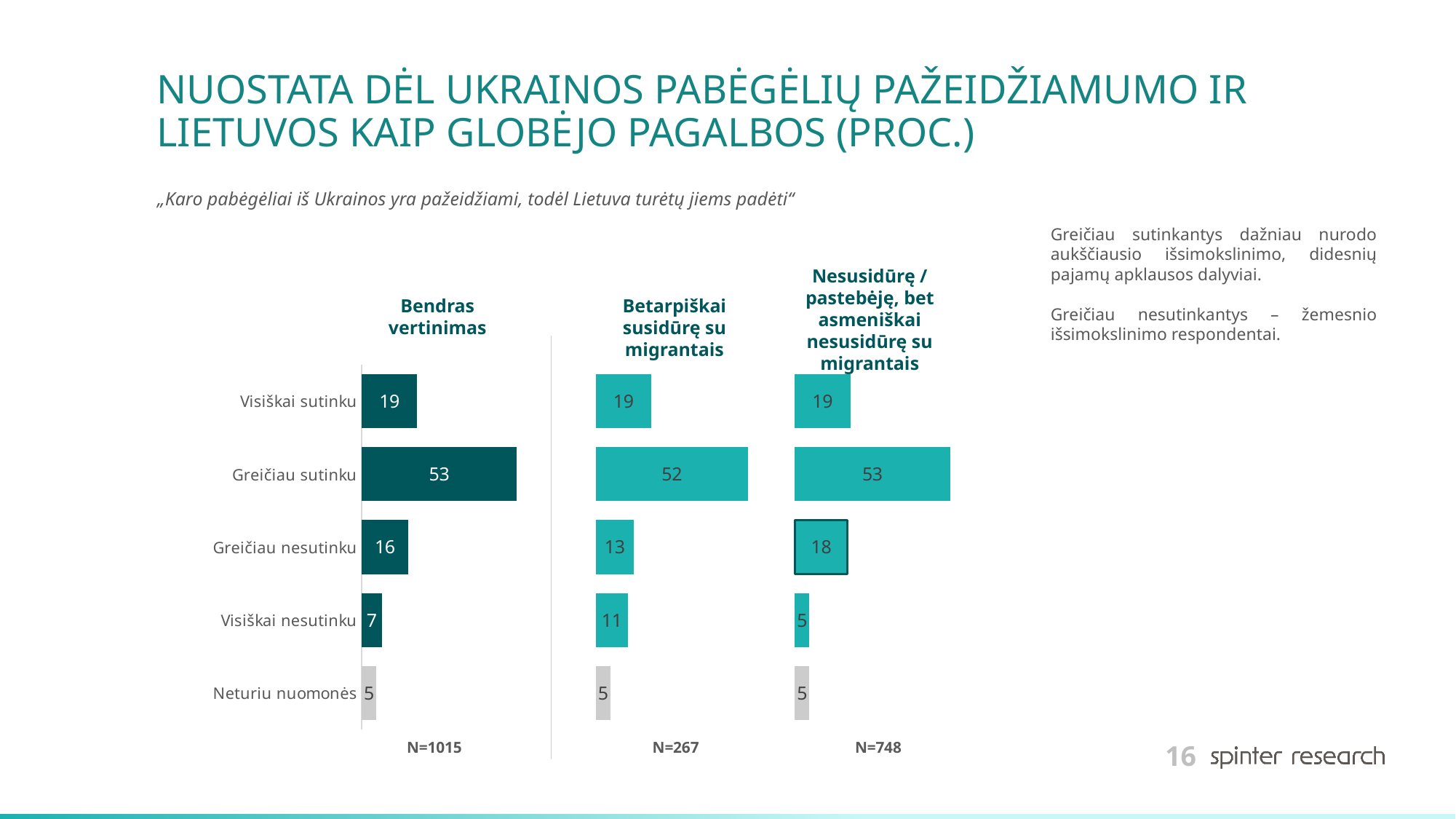
What is the sample size (N) shown under the "Betarpiškai susidūrę su migrantais" chart? N=267 Which is larger: "Greičiau nesutinku" in the "Betarpiškai susidūrę su migrantais" chart or "Greičiau nesutinku" in the "Nesusidūrę / pastebėję, bet asmeniškai nesusidūrę su migrantais" chart? Nesusidūrę / pastebėję, bet asmeniškai nesusidūrę su migrantais In the "Bendras vertinimas" chart, what is the difference between "Greičiau sutinku" and "Visiškai sutinku"? 34 In the "Betarpiškai susidūrę su migrantais" chart, what is the difference between "Greičiau nesutinku" and "Visiškai nesutinku"? 2 In the "Bendras vertinimas" chart, what is the value for "Visiškai nesutinku"? 7 In the "Betarpiškai susidūrę su migrantais" chart, which category has the lowest value? Neturiu nuomonės What kind of chart is the "Bendras vertinimas" chart? Bar chart In the "Nesusidūrę / pastebėję, bet asmeniškai nesusidūrę su migrantais" chart, what is the value for "Greičiau nesutinku"? 18 How many categories are shown in the "Bendras vertinimas" chart? 5 In the "Bendras vertinimas" chart, what is the value for "Greičiau sutinku"? 53 In the "Betarpiškai susidūrę su migrantais" chart, what is the value for "Visiškai nesutinku"? 11 In the "Bendras vertinimas" chart, which category has the highest value? Greičiau sutinku